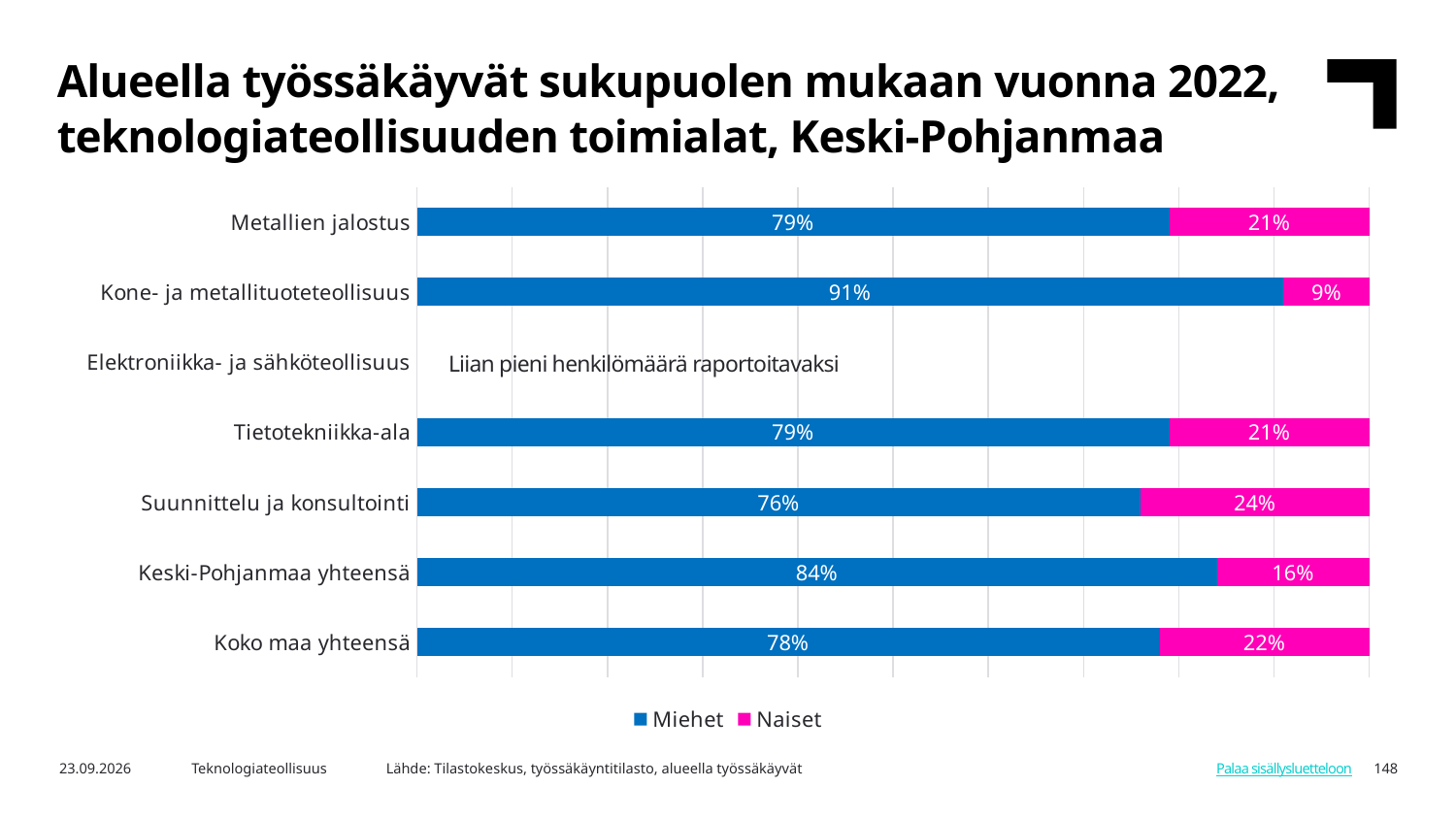
Which category has the lowest Naiset share? Kone- ja metallituoteteollisuus What is the difference between the Miehet share for Keski-Pohjanmaa yhteensä and Koko maa yhteensä? 6 percentage points What is the Naiset share for Suunnittelu ja konsultointi? 24% Is the Naiset share larger for Metallien jalostus or for Keski-Pohjanmaa yhteensä? Metallien jalostus What is the Miehet share for Kone- ja metallituoteteollisuus? 91% What is the Miehet share for Keski-Pohjanmaa yhteensä? 84% What is the Naiset share for Koko maa yhteensä? 22% What kind of chart is shown on the slide? Stacked bar chart What text is shown instead of a bar for Elektroniikka- ja sähköteollisuus? Liian pieni henkilömäärä raportoitavaksi Which category has the highest Naiset share? Suunnittelu ja konsultointi How many series does the legend list? 2 Which category has the highest Miehet share? Kone- ja metallituoteteollisuus